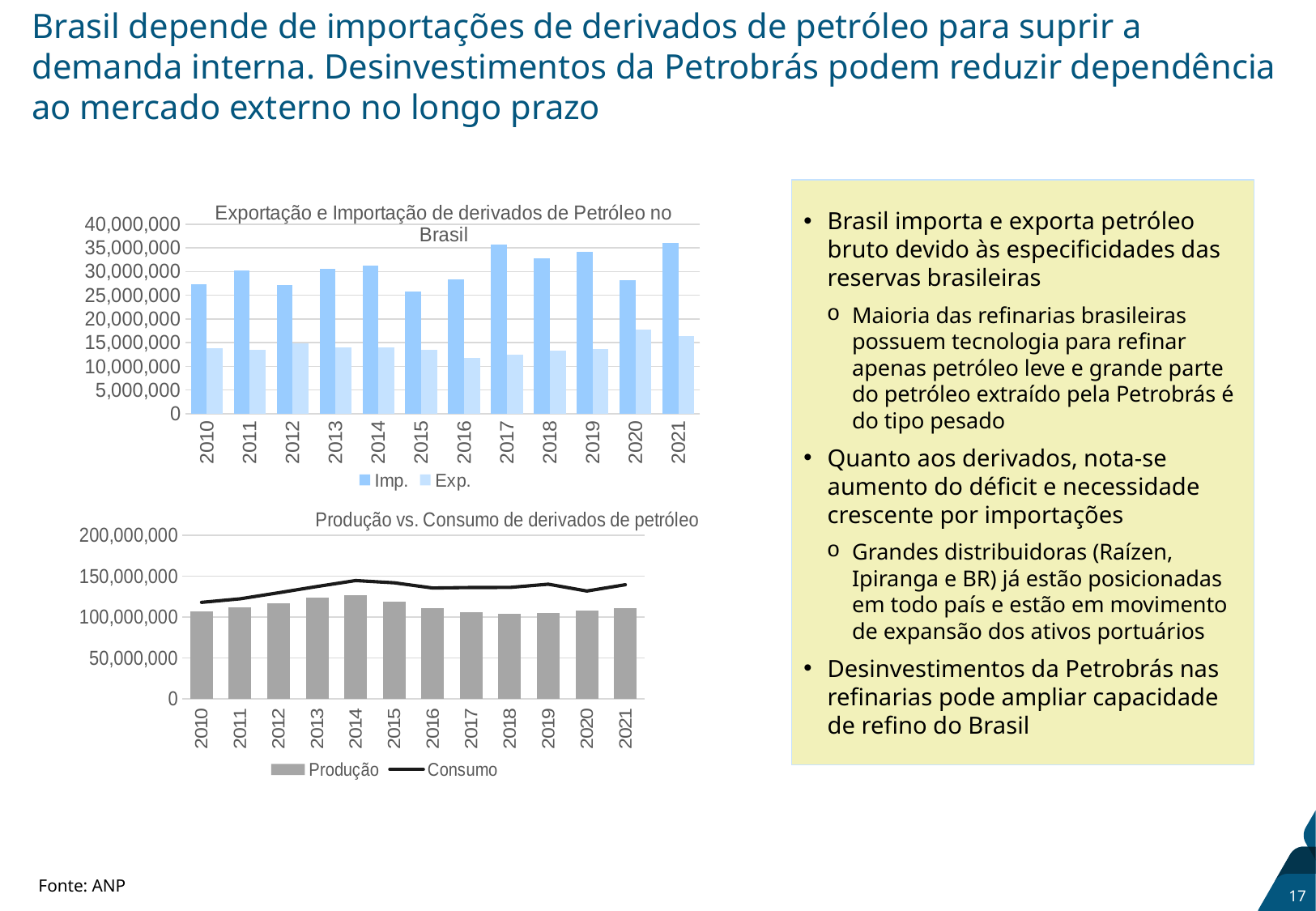
In the chart 'Exportação e Importação de derivados de Petróleo no Brasil', is the Imp. value for 2015 greater or less than 30,000,000? less What are the two legend entries of the chart 'Produção vs. Consumo de derivados de petróleo'? Produção and Consumo In the chart 'Produção vs. Consumo de derivados de petróleo', is the Consumo value for 2014 greater or less than 100,000,000? greater How many series does the legend of the chart 'Exportação e Importação de derivados de Petróleo no Brasil' list? 2 In the chart 'Exportação e Importação de derivados de Petróleo no Brasil', is the Exp. value for 2020 greater or less than 15,000,000? greater In the chart 'Exportação e Importação de derivados de Petróleo no Brasil', which is larger in 2019, Imp. or Exp.? Imp. In the chart 'Produção vs. Consumo de derivados de petróleo', which is larger in 2014, Produção or Consumo? Consumo How many years are shown on the x axis of the chart 'Exportação e Importação de derivados de Petróleo no Brasil'? 12 In the chart 'Exportação e Importação de derivados de Petróleo no Brasil', which year has the highest Exp. value? 2020 In the chart 'Exportação e Importação de derivados de Petróleo no Brasil', which year has the lowest Exp. value? 2016 What kind of chart is 'Exportação e Importação de derivados de Petróleo no Brasil'? Bar chart In the chart 'Produção vs. Consumo de derivados de petróleo', which year has the highest Produção value? 2014